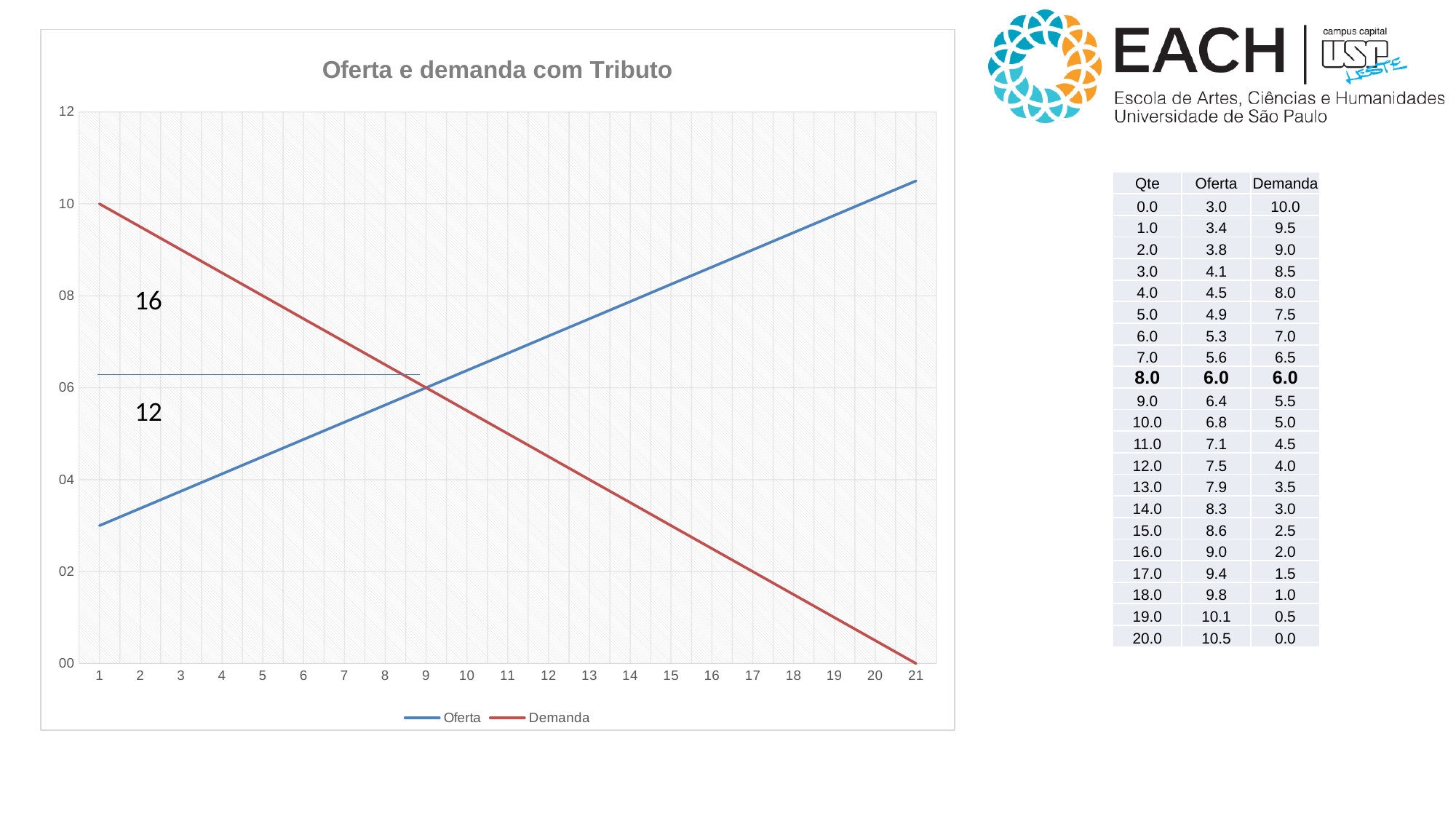
At x = 5, which series has the higher value, Oferta or Demanda? Demanda What is the title of the chart? Oferta e demanda com Tributo What kind of chart is shown on the slide? line chart Is the value of Oferta at x = 21 greater or less than 10? greater Does the Demanda line rise or fall as the x axis increases? falls Does the Oferta line rise or fall as the x axis increases? rises How many series does the chart legend list? 2 At x = 15, which series has the higher value, Oferta or Demanda? Oferta How many points are labelled along the x axis of the chart? 21 What are the two series named in the chart legend? Oferta and Demanda What is the value of Demanda at x = 1? 10 Is the value of Oferta at x = 1 greater or less than 4? less